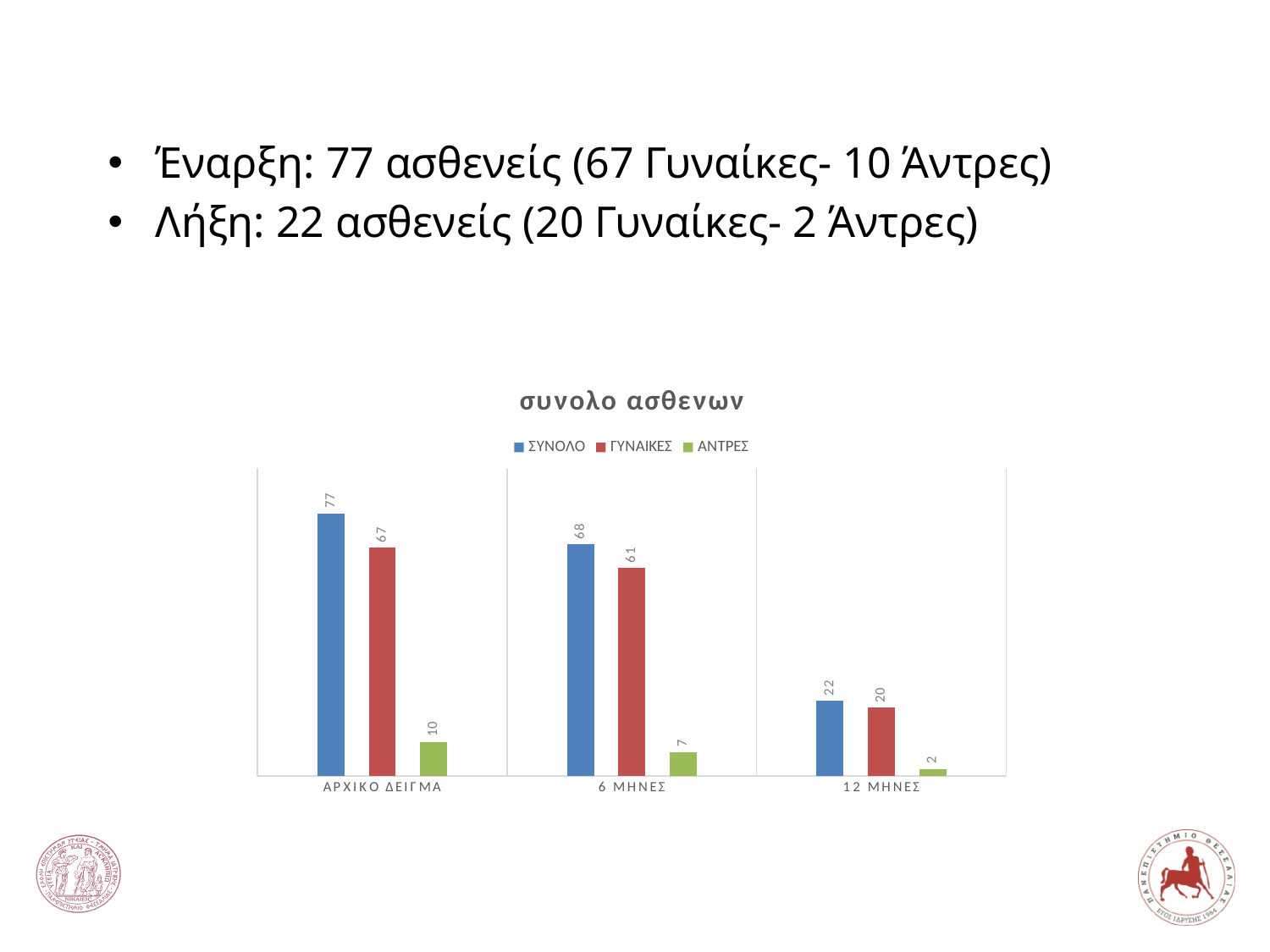
Which category has the lowest ΓΥΝΑΙΚΕΣ value? 12 ΜΗΝΕΣ Do the ΣΥΝΟΛΟ values rise or fall from ΑΡΧΙΚΟ ΔΕΙΓΜΑ to 12 ΜΗΝΕΣ? Fall How many categories are shown on the x axis? 3 What is the difference between the ΣΥΝΟΛΟ values for ΑΡΧΙΚΟ ΔΕΙΓΜΑ and 6 ΜΗΝΕΣ? 9 How many series does the legend list? 3 Which is larger: ΑΝΤΡΕΣ at ΑΡΧΙΚΟ ΔΕΙΓΜΑ or ΑΝΤΡΕΣ at 6 ΜΗΝΕΣ? ΑΡΧΙΚΟ ΔΕΙΓΜΑ Which category has the highest ΣΥΝΟΛΟ value? ΑΡΧΙΚΟ ΔΕΙΓΜΑ What is the difference between ΓΥΝΑΙΚΕΣ and ΑΝΤΡΕΣ at 12 ΜΗΝΕΣ? 18 What is the value of ΣΥΝΟΛΟ for ΑΡΧΙΚΟ ΔΕΙΓΜΑ? 77 What kind of chart is shown? Bar chart What is the value of ΓΥΝΑΙΚΕΣ at 6 ΜΗΝΕΣ? 61 What is the value of ΑΝΤΡΕΣ at 12 ΜΗΝΕΣ? 2